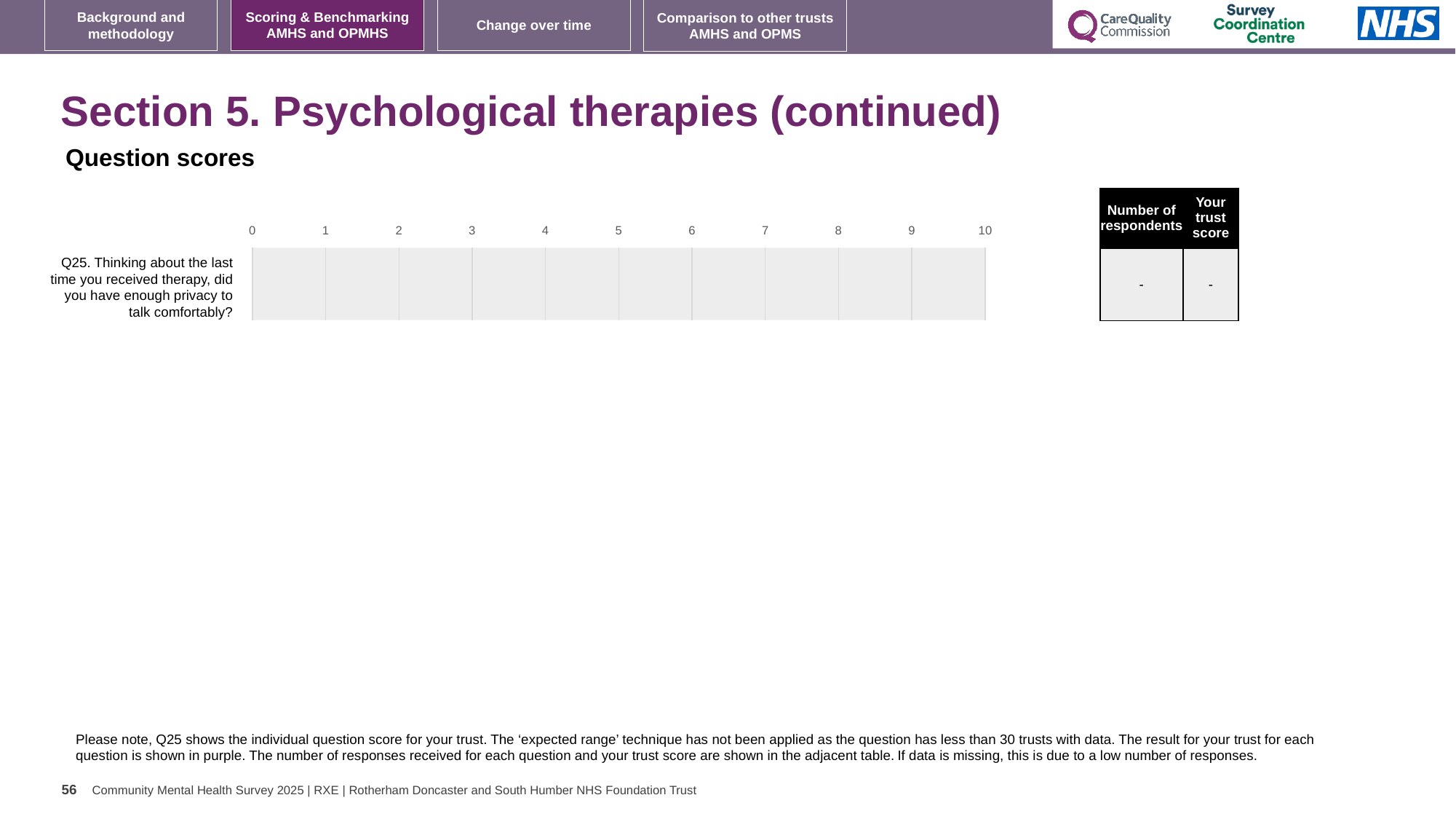
What is the highest value shown on the chart's x axis? 10 How many questions are listed on the chart? 1 What is the 'Your trust score' value shown for Q25 in the adjacent table? - What is the 'Number of respondents' value shown for Q25 in the adjacent table? - What is the lowest value shown on the chart's x axis? 0